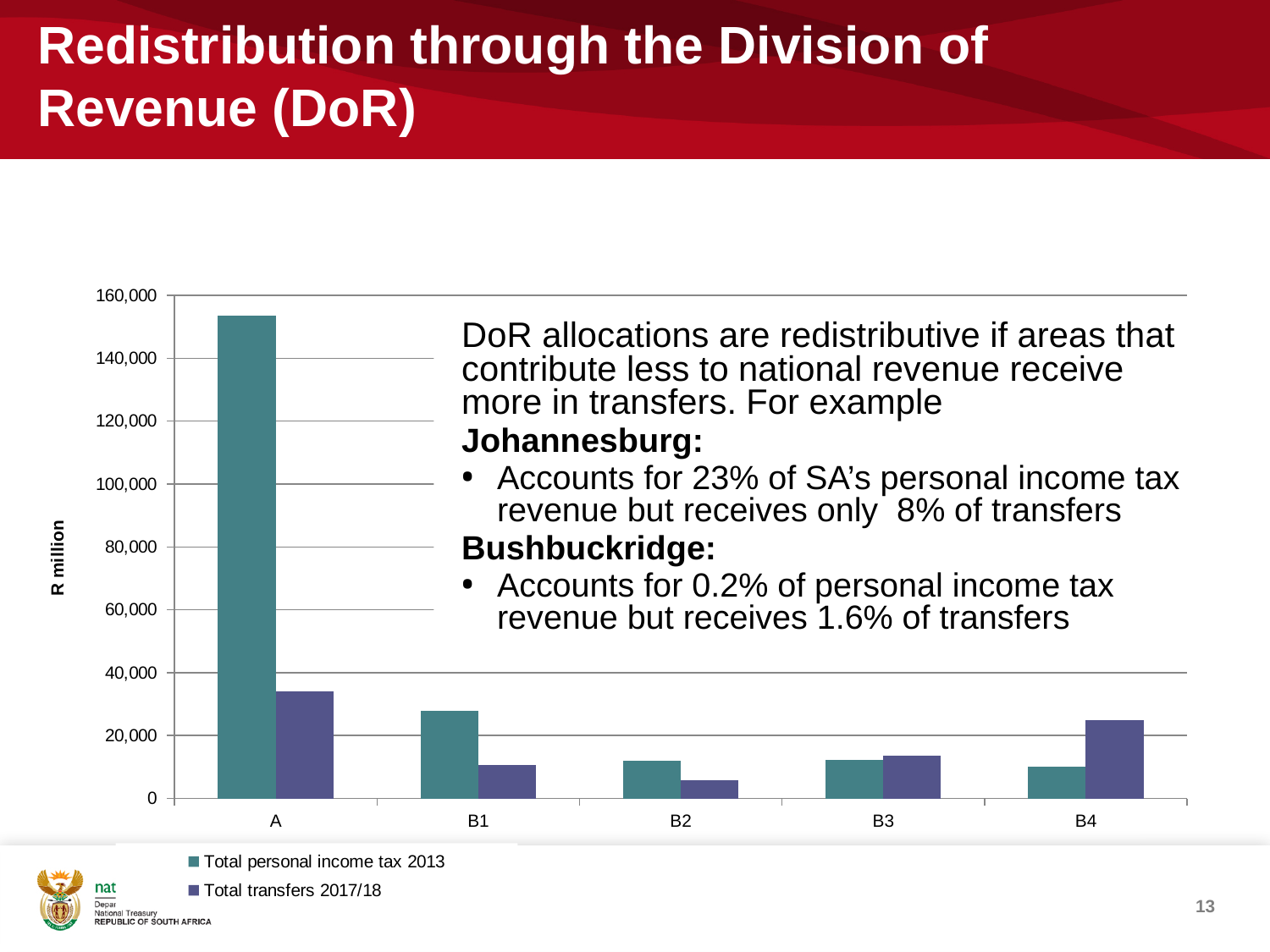
What is the label on the vertical axis of the chart? R million Is the Total transfers 2017/18 value for A greater or less than 40,000? less Which category has the highest value for Total personal income tax 2013? A Which category has the lowest value for Total transfers 2017/18? B2 Which category has the highest value for Total transfers 2017/18? A Is the Total personal income tax 2013 value for A greater or less than 140,000? greater What kind of chart is shown on the slide? Bar chart For category B4, which is larger: Total personal income tax 2013 or Total transfers 2017/18? Total transfers 2017/18 How many categories are shown on the x axis of the chart? 5 Is the Total transfers 2017/18 value for B4 greater or less than 20,000? greater How many series does the chart's legend list? 2